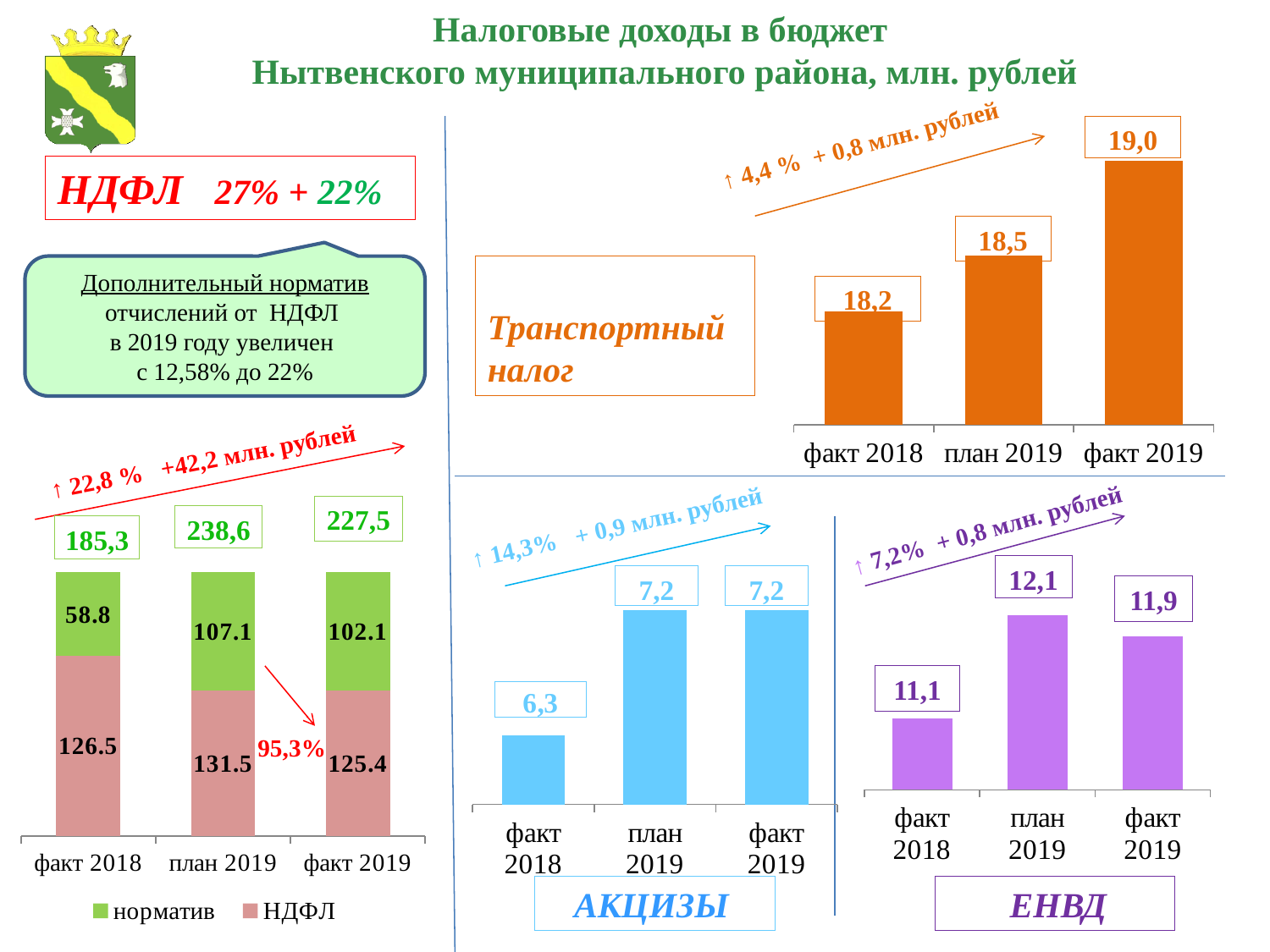
In the Транспортный налог chart, what is the difference between факт 2019 and факт 2018? 0,8 In the ЕНВД chart, which is larger: факт 2018 or факт 2019? факт 2019 In the НДФЛ stacked bar chart (bottom left), what is the value of the норматив segment for план 2019? 107.1 In the НДФЛ stacked bar chart (bottom left), what is the total of the факт 2018 bar? 185,3 In the АКЦИЗЫ chart, do the values rise or fall from факт 2018 to план 2019? rise In the Транспортный налог chart, which category has the lowest value? факт 2018 What kind of chart is the Транспортный налог chart? bar chart In the ЕНВД chart, which category has the highest value? план 2019 In the Транспортный налог chart, what is the value for факт 2019? 19,0 In the АКЦИЗЫ chart, what is the value for факт 2018? 6,3 In the ЕНВД chart, what is the value for факт 2019? 11,9 How many series does the legend of the НДФЛ stacked bar chart (bottom left) list? 2